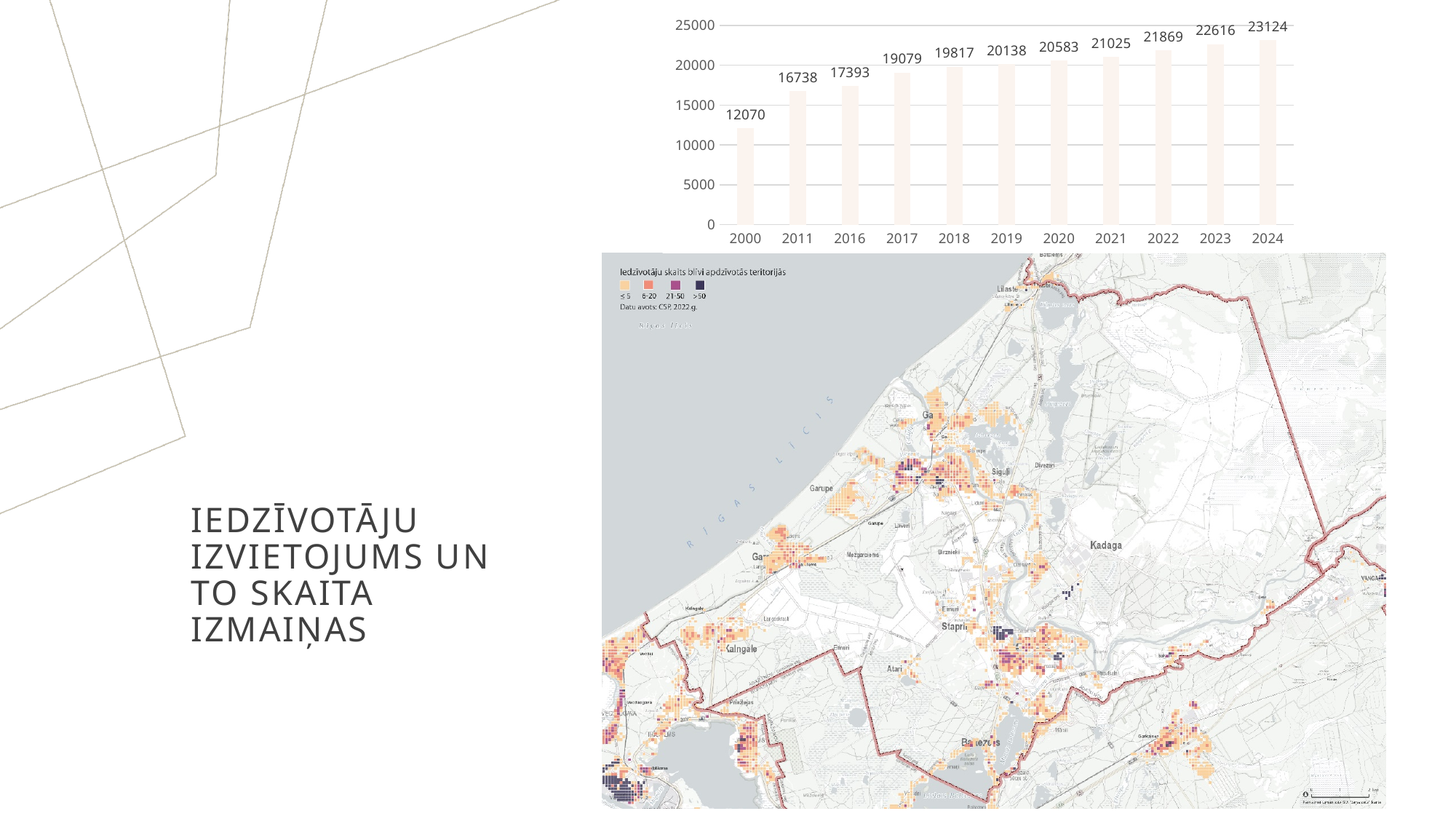
What is the value shown for 2024 in the bar chart? 23124 Which is larger in the bar chart, the value for 2011 or the value for 2017? 2017 What is the value shown for 2020 in the bar chart? 20583 What is the value shown for 2000 in the bar chart? 12070 Which year has the lowest value in the bar chart? 2000 Which year has the highest value in the bar chart? 2024 What is the value shown for 2016 in the bar chart? 17393 Do the values in the bar chart rise or fall from 2000 to 2024? rise How many years (bars) are shown in the bar chart? 11 What kind of chart is shown at the top of the slide? bar chart What is the difference between the values for 2024 and 2000 in the bar chart? 11054 What is the difference between the values for 2023 and 2022 in the bar chart? 747